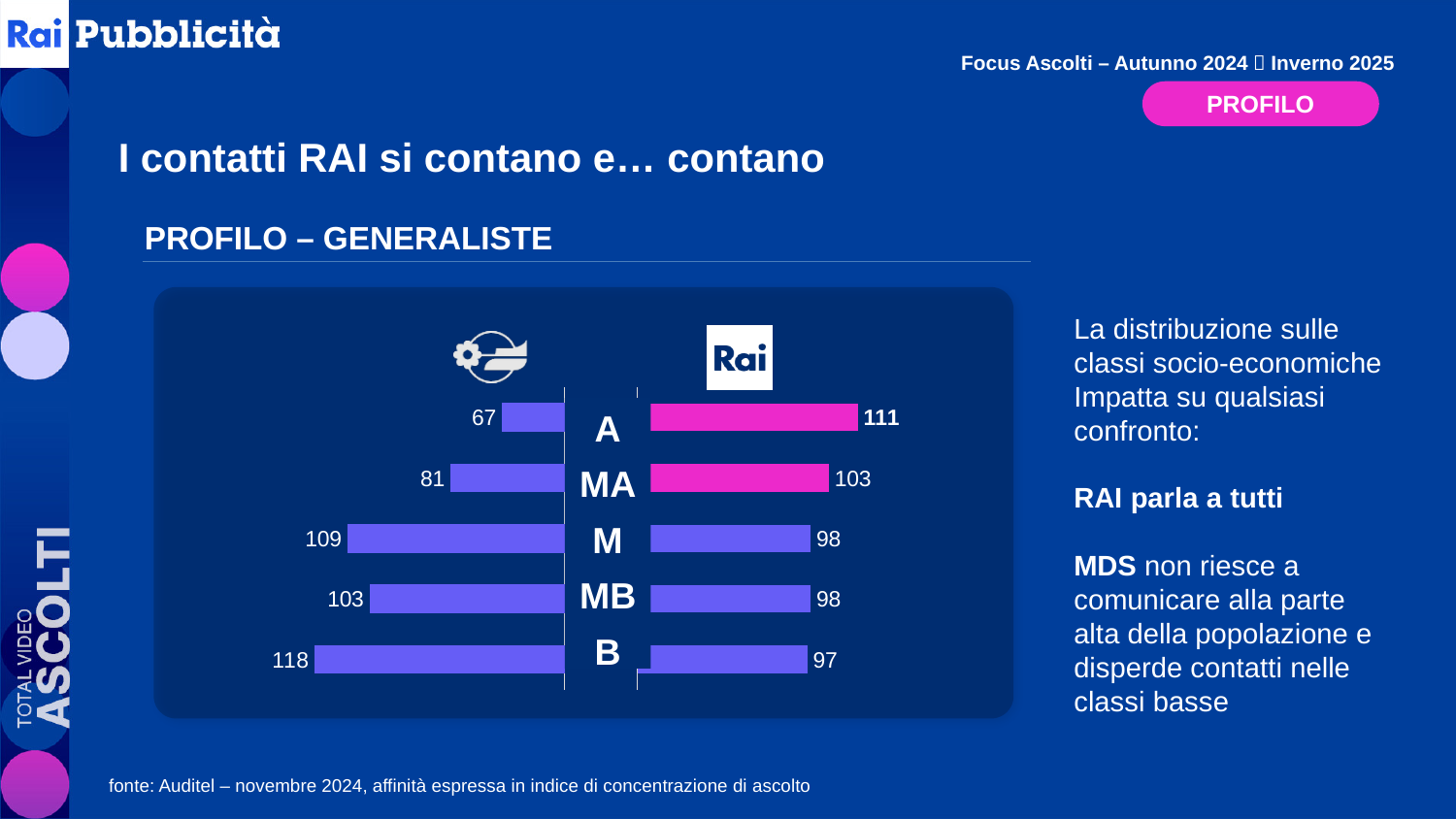
How many socio-economic classes are shown in the chart? 5 What is the value for class MA on the left-hand side of the chart? 81 What is the difference between the Rai value and the left-hand value for class A? 44 Which class has the highest value on the left-hand side of the chart? B What is the Rai value for class MA? 103 For class B, which is larger: the Rai value or the left-hand value? the left-hand value (118) Which class has the highest Rai value? A What is the Rai value for class A in the PROFILO – GENERALISTE chart? 111 What is the value for class B on the left-hand side of the chart? 118 Do the Rai values rise or fall going from class A down to class B? fall Which class has the lowest value on the left-hand side of the chart? A What kind of chart is shown on the slide? bar chart